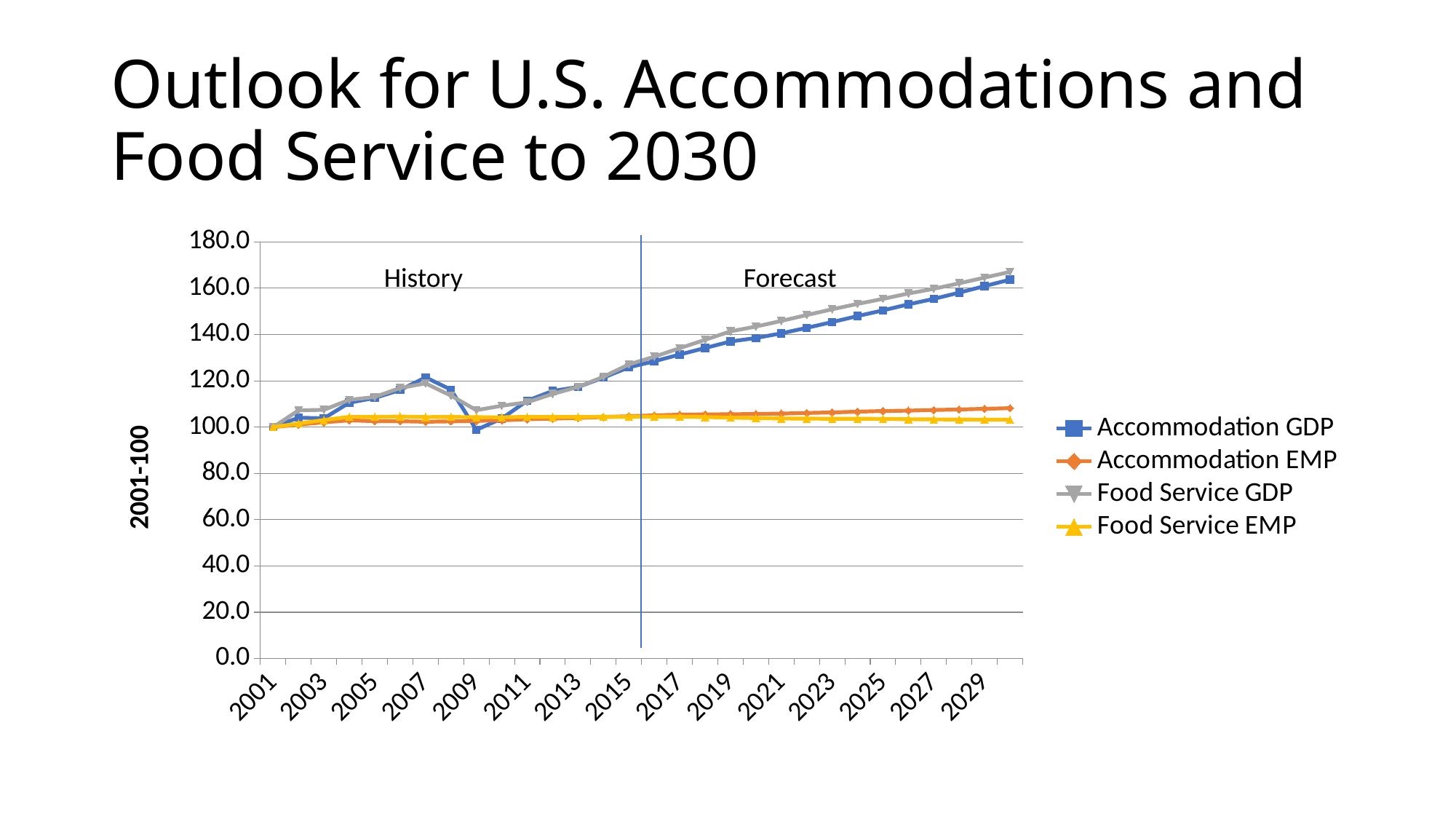
What kind of chart is shown on the slide? Line chart Is the value for Accommodation EMP in 2030 greater or less than 120? less How many series does the legend list? 4 In 2030, which is larger: Food Service GDP or Accommodation GDP? Food Service GDP What is the label on the vertical axis? 2001-100 Is the value for Food Service GDP in 2030 greater or less than 160? greater Which series has the highest value in 2030? Food Service GDP Is the value for Accommodation GDP in 2021 greater or less than 120? greater What are the two labels printed inside the plot area on either side of the vertical divider line? History and Forecast Which series has the lowest value in 2030? Food Service EMP Does Accommodation GDP rise or fall from 2016 to 2030? Rises In 2030, which is larger: Accommodation EMP or Food Service EMP? Accommodation EMP